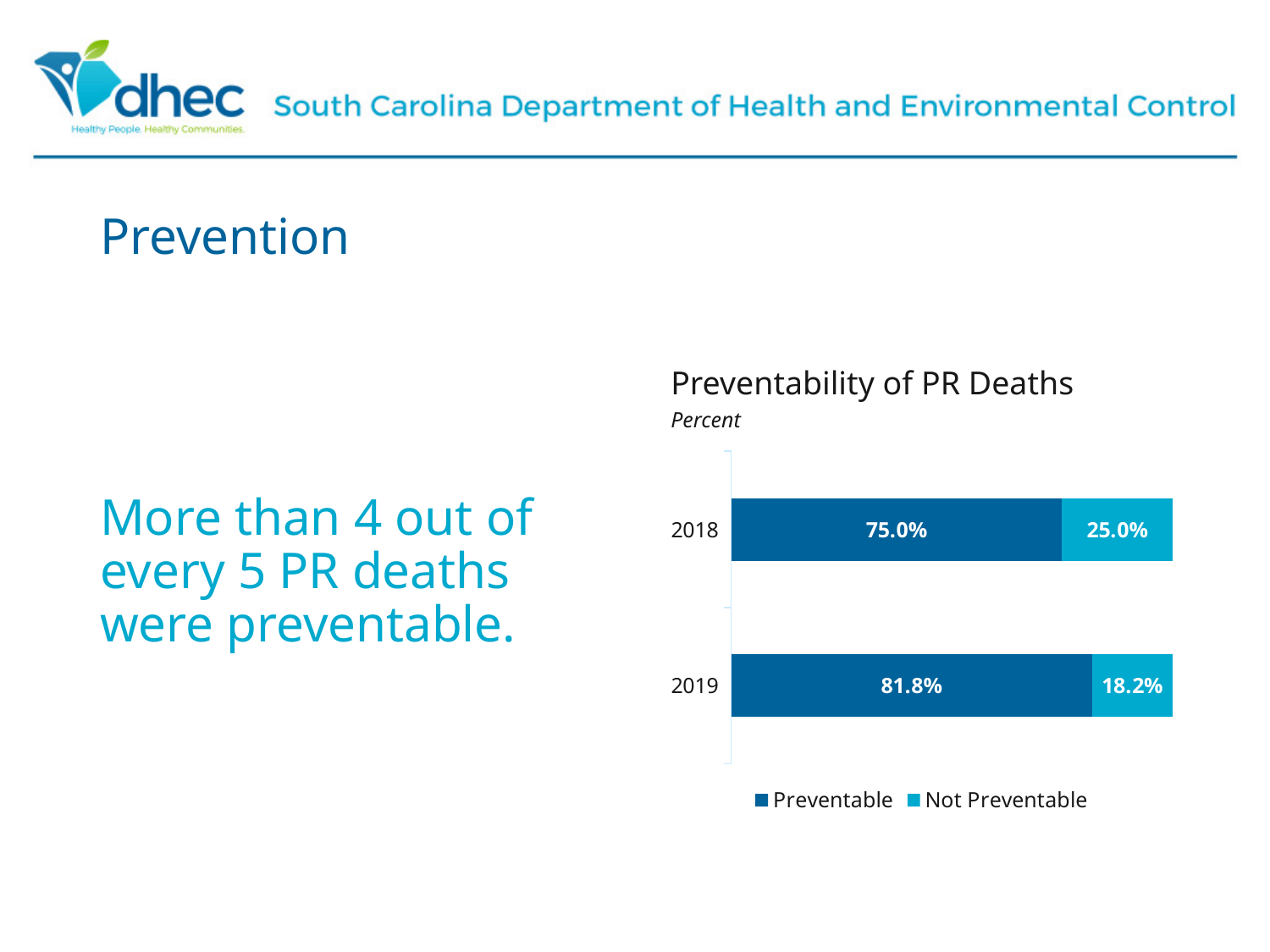
What percentage of PR deaths were Not Preventable in 2019? 18.2% Which year had the lower Not Preventable percentage? 2019 How many years are shown in the chart? 2 By how many percentage points did the Preventable share increase from 2018 to 2019? 6.8 Is the Not Preventable percentage larger in 2018 or 2019? 2018 What percentage of PR deaths were Preventable in 2018? 75.0% What type of chart is shown on the slide? Stacked bar chart What percentage of PR deaths were Not Preventable in 2018? 25.0% How many series does the legend list? 2 What is the title of the chart? Preventability of PR Deaths What percentage of PR deaths were Preventable in 2019? 81.8% Which year had the higher Preventable percentage? 2019